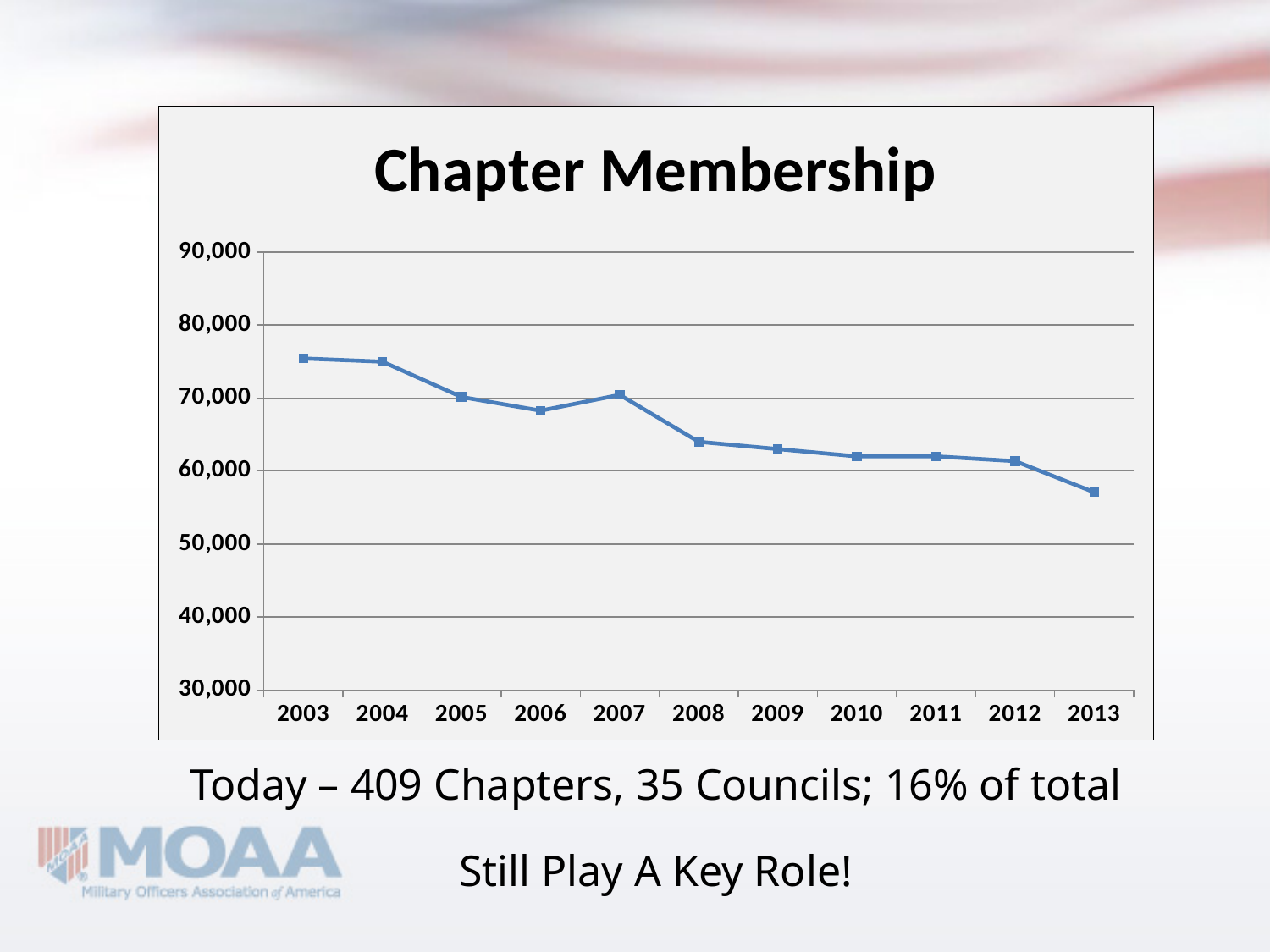
Which year has the larger chapter membership, 2007 or 2008? 2007 Which year has the lowest chapter membership? 2013 Which year has the larger chapter membership, 2005 or 2013? 2005 Overall, do the chapter membership values rise or fall from 2003 to 2013? fall Is the value for 2008 greater or less than 70,000? less Is the value for 2003 greater or less than 70,000? greater What is the title of the chart? Chapter Membership What kind of chart is shown on the slide? line chart Is the value for 2013 greater or less than 60,000? less How many years are plotted on the x axis of the chart? 11 What is the lowest value shown on the y axis of the chart? 30,000